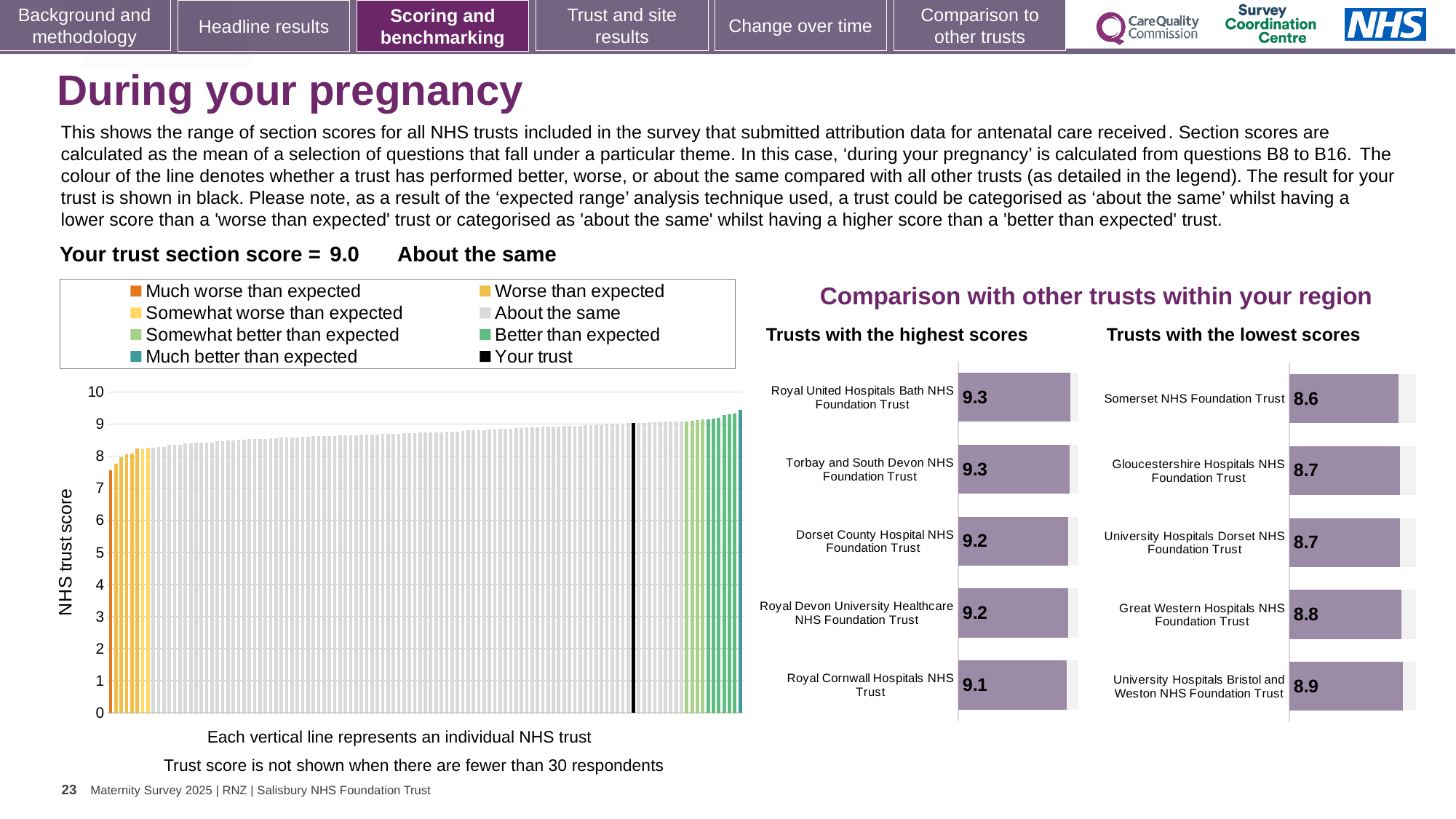
In the 'Trusts with the lowest scores' chart, which has the larger score: Great Western Hospitals NHS Foundation Trust or Somerset NHS Foundation Trust? Great Western Hospitals NHS Foundation Trust In the left-hand NHS trust score chart, is the value of the leftmost bar greater or less than 8? less In the 'Trusts with the lowest scores' chart, what is the score for Somerset NHS Foundation Trust? 8.6 In the 'Trusts with the highest scores' chart, what is the score for Royal United Hospitals Bath NHS Foundation Trust? 9.3 How many trusts are shown in the 'Trusts with the lowest scores' chart? 5 What is the label on the vertical axis of the left-hand chart? NHS trust score In the 'Trusts with the highest scores' chart, which trust has the lowest score? Royal Cornwall Hospitals NHS Trust In the 'Trusts with the lowest scores' chart, which trust has the highest score? University Hospitals Bristol and Weston NHS Foundation Trust How many entries does the legend of the left-hand NHS trust score chart list? 8 What kind of chart is the left-hand chart showing NHS trust scores? Bar chart In the left-hand NHS trust score chart, do the bar heights rise or fall from left to right? Rise In the 'Trusts with the highest scores' chart, what is the difference between the scores of Royal United Hospitals Bath NHS Foundation Trust and Royal Cornwall Hospitals NHS Trust? 0.2